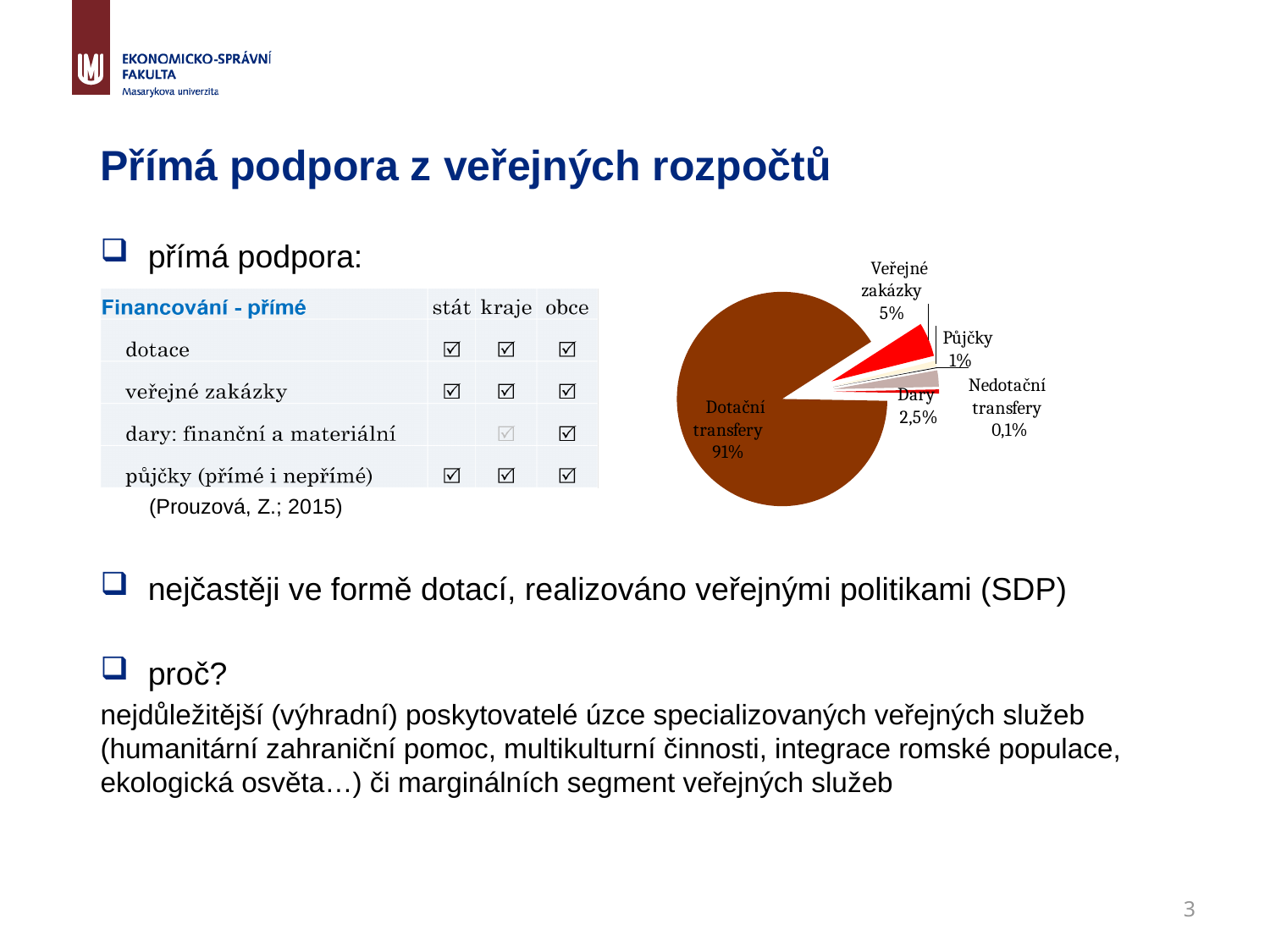
Which is larger, the share for Dary or the share for Půjčky? Dary What is the difference in percentage points between Veřejné zakázky and Dary? 2,5 What kind of chart is shown on the slide? pie chart Which slice of the pie chart is the smallest? Nedotační transfery What share of the pie does Dary have? 2,5% What share of the pie does Dotační transfery have? 91% What share of the pie does Veřejné zakázky have? 5% What is the difference in percentage points between Dotační transfery and Veřejné zakázky? 86 Which slice of the pie chart is the largest? Dotační transfery